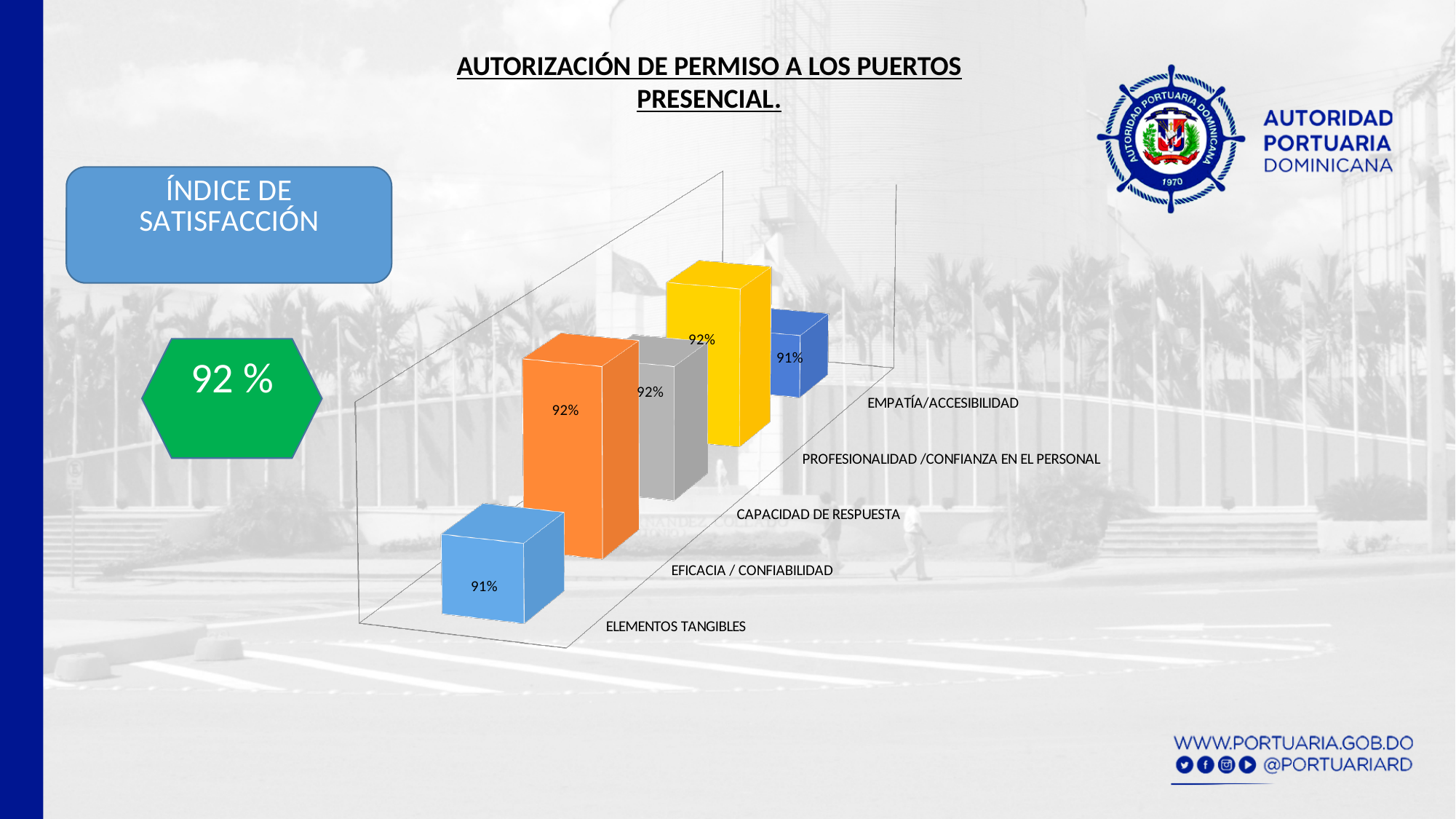
How many categories are shown in the chart? 5 What is the value for CAPACIDAD DE RESPUESTA? 92% What is the title shown above the chart? AUTORIZACIÓN DE PERMISO A LOS PUERTOS PRESENCIAL. What colour is the bar for CAPACIDAD DE RESPUESTA? Grey What kind of chart is shown on the slide? Bar chart Which is larger, the value for EMPATÍA/ACCESIBILIDAD or the value for CAPACIDAD DE RESPUESTA? CAPACIDAD DE RESPUESTA What is the value for ELEMENTOS TANGIBLES? 91% What is the value for EFICACIA / CONFIABILIDAD? 92% What is the value for EMPATÍA/ACCESIBILIDAD? 91% Which is larger, the value for EFICACIA / CONFIABILIDAD or the value for ELEMENTOS TANGIBLES? EFICACIA / CONFIABILIDAD What is the value for PROFESIONALIDAD /CONFIANZA EN EL PERSONAL? 92% What is the difference between the value for EFICACIA / CONFIABILIDAD and the value for ELEMENTOS TANGIBLES? 1%